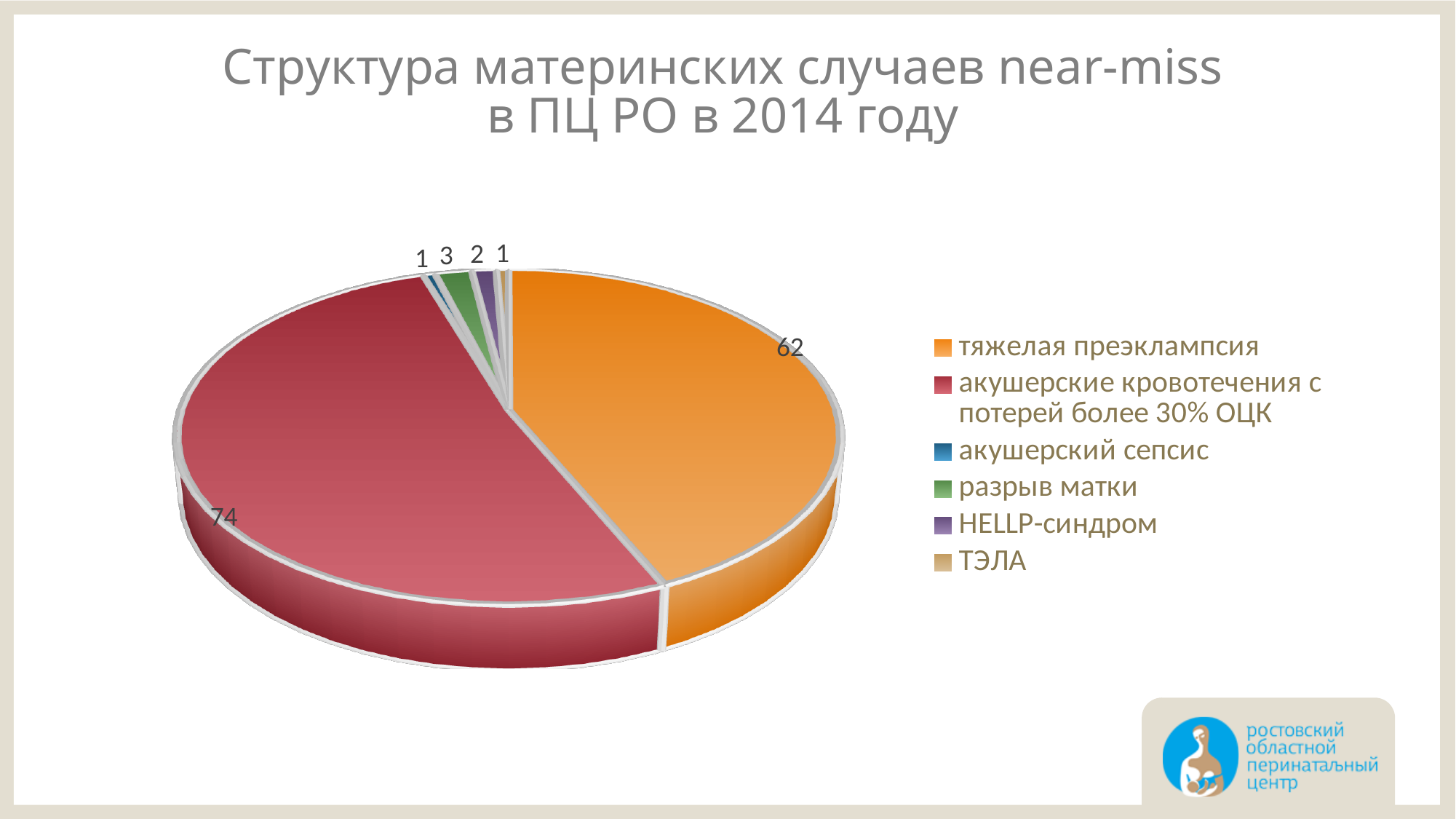
What is the difference between the values for акушерские кровотечения с потерей более 30% ОЦК and тяжелая преэклампсия? 12 Which category has the largest slice of the pie? акушерские кровотечения с потерей более 30% ОЦК What kind of chart is shown on the slide? pie chart What is the value for акушерские кровотечения с потерей более 30% ОЦК? 74 What is the value for HELLP-синдром? 2 How many categories does the pie chart have? 6 What colour is the slice for тяжелая преэклампсия? orange What is the value for разрыв матки? 3 What is the total of all the values shown on the pie chart? 143 Which is larger, the value for тяжелая преэклампсия or the value for акушерские кровотечения с потерей более 30% ОЦК? акушерские кровотечения с потерей более 30% ОЦК What is the value for тяжелая преэклампсия? 62 What is the title of the chart on the slide? Структура материнских случаев near-miss в ПЦ РО в 2014 году